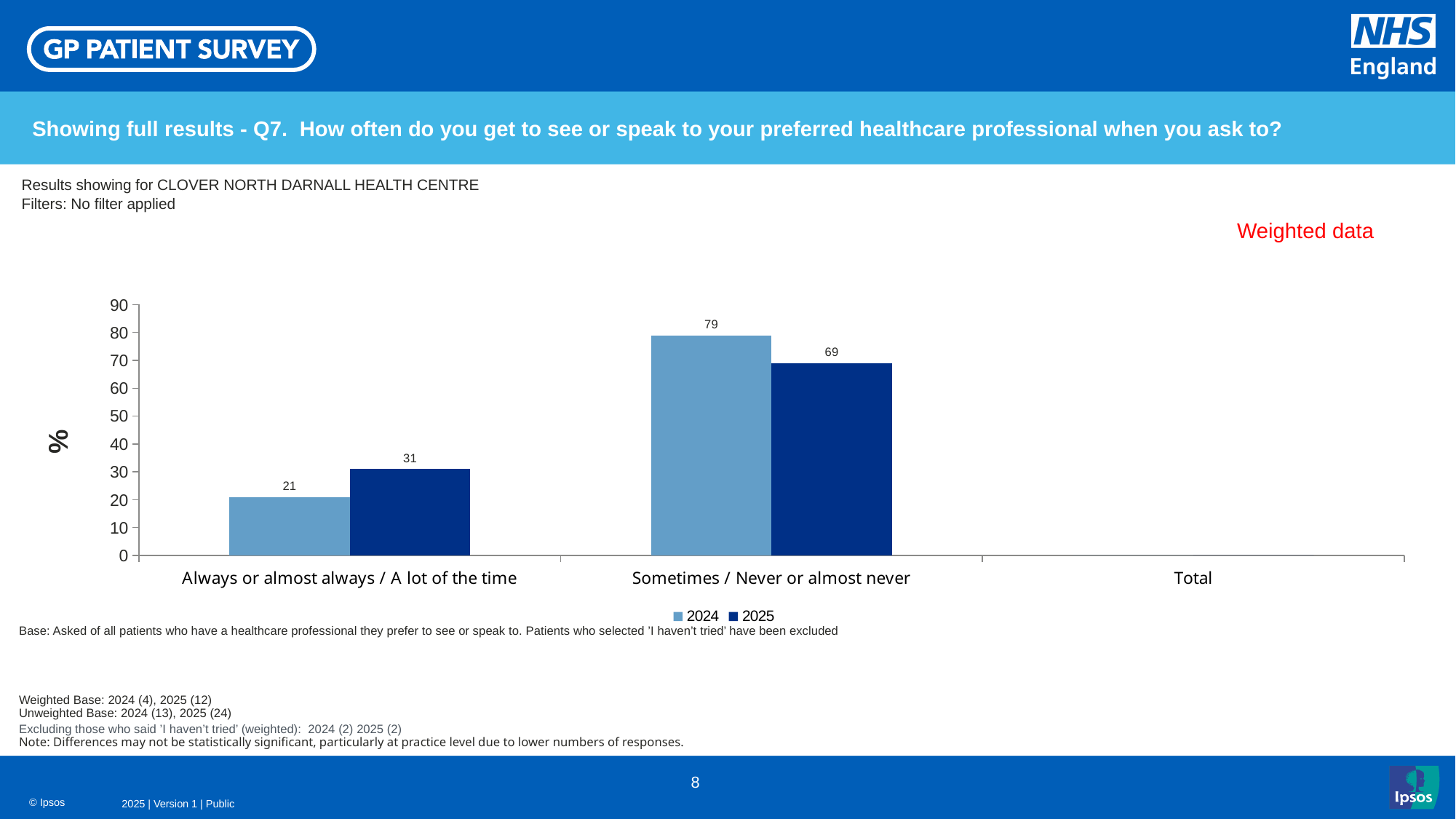
What kind of chart is shown on the slide? Bar chart What is the 2024 value for 'Sometimes / Never or almost never'? 79 What is the difference between the 2024 and 2025 values for 'Sometimes / Never or almost never'? 10 How many categories are shown on the x axis? 3 What is the 2025 value for 'Sometimes / Never or almost never'? 69 Which is larger for 'Always or almost always / A lot of the time': the 2024 value or the 2025 value? 2025 How many series does the legend list? 2 What is the label on the vertical axis? % Which category has the highest 2024 value? Sometimes / Never or almost never What is the 2024 value for 'Always or almost always / A lot of the time'? 21 Which category has the lowest 2025 value? Always or almost always / A lot of the time What is the 2025 value for 'Always or almost always / A lot of the time'? 31